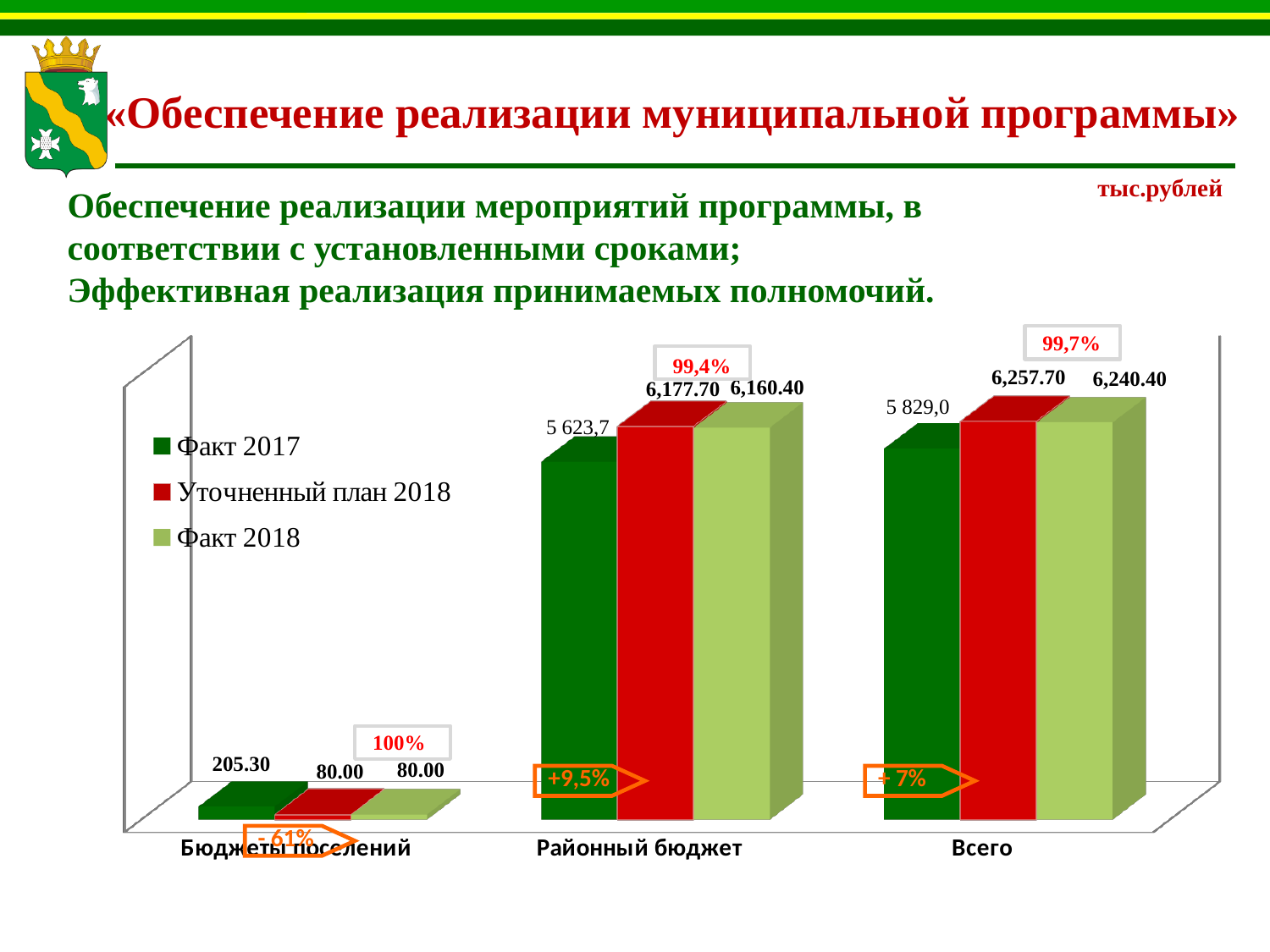
How many series does the legend list? 3 What is the difference between Факт 2017 and Факт 2018 for Бюджеты поселений? 125.30 What is the value of Факт 2017 for Бюджеты поселений? 205.30 What unit is indicated for the chart values? тыс.рублей Which category has the lowest Уточненный план 2018 value? Бюджеты поселений What is the value of Уточненный план 2018 for Районный бюджет? 6,177.70 What kind of chart is shown on the slide? bar chart What is the value of Факт 2017 for Всего? 5 829,0 Which is larger for Районный бюджет: Факт 2017 or Уточненный план 2018? Уточненный план 2018 How many categories are shown on the x axis? 3 What is the value of Факт 2018 for Всего? 6,240.40 Which category has the highest Факт 2018 value? Всего